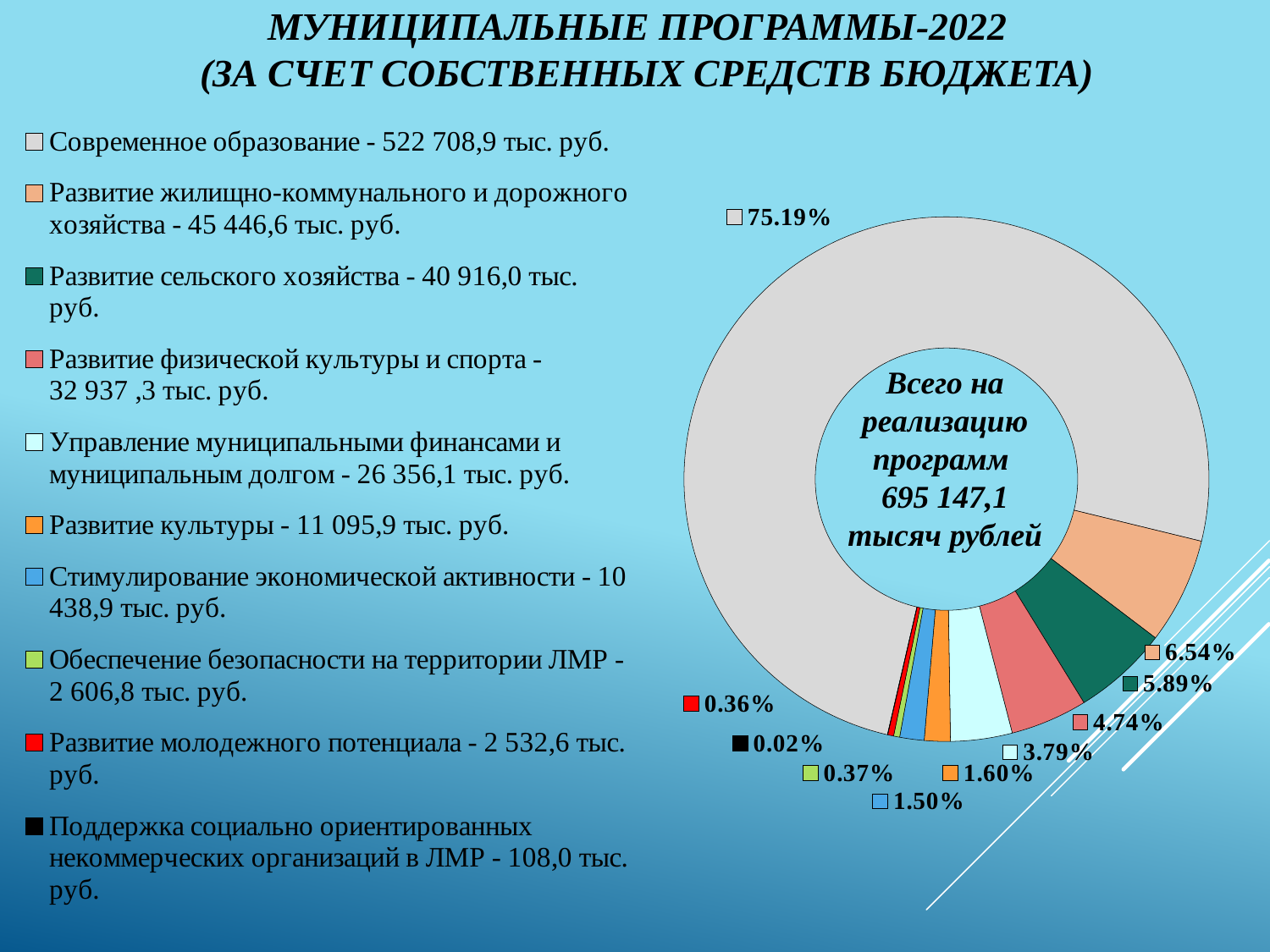
Which program has the smallest slice of the pie? Поддержка социально ориентированных некоммерческих организаций в ЛМР What amount is listed for Развитие культуры? 11 095,9 тыс. руб. Which has the larger share: Развитие сельского хозяйства or Развитие физической культуры и спорта? Развитие сельского хозяйства What share of the pie does Стимулирование экономической активности account for? 1.50% How many programs (slices) are shown in the chart? 10 What is the difference in percentage points between the shares of Развитие жилищно-коммунального и дорожного хозяйства (6.54%) and Развитие сельского хозяйства (5.89%)? 0.65 percentage points What share of the pie does Современное образование account for? 75.19% What colour is the slice for Развитие молодежного потенциала? Red Which program has the largest slice of the pie? Современное образование What share of the pie does Развитие жилищно-коммунального и дорожного хозяйства account for? 6.54% What kind of chart is shown on the slide? Pie (doughnut) chart What is the total amount for implementing the programs, as shown in the centre of the chart? 695 147,1 тысяч рублей